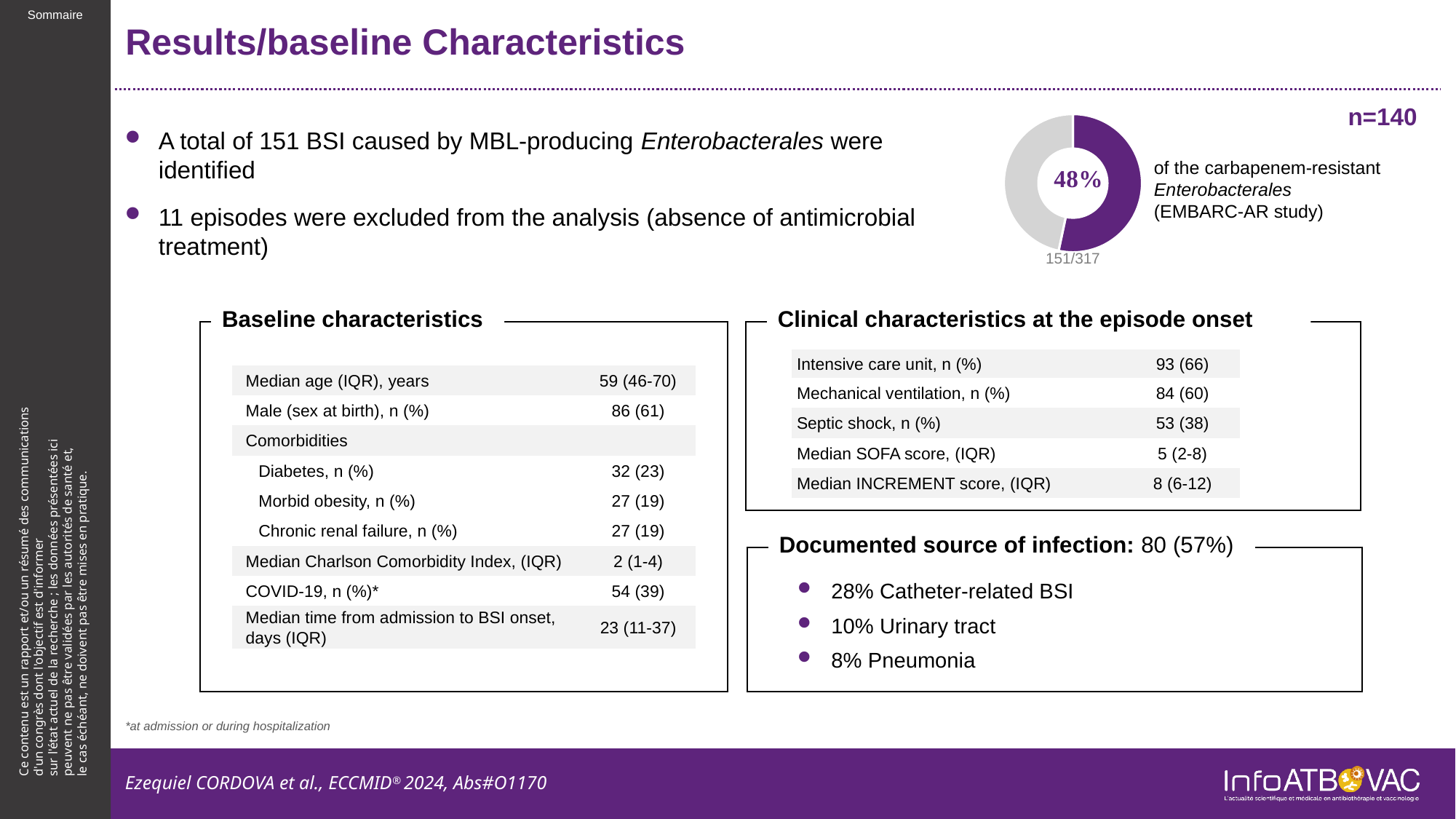
What kind of chart is shown at the top right of the slide? donut (pie) chart According to the text next to the donut chart, the 48% is a share of what? the carbapenem-resistant Enterobacterales (EMBARC-AR study) What colour is the 48% slice of the donut chart? purple What fraction is printed below the donut chart? 151/317 How many slices does the donut chart have? 2 What percentage is printed in the centre of the donut chart? 48% Is the share shown in the donut chart greater or less than 50%? less